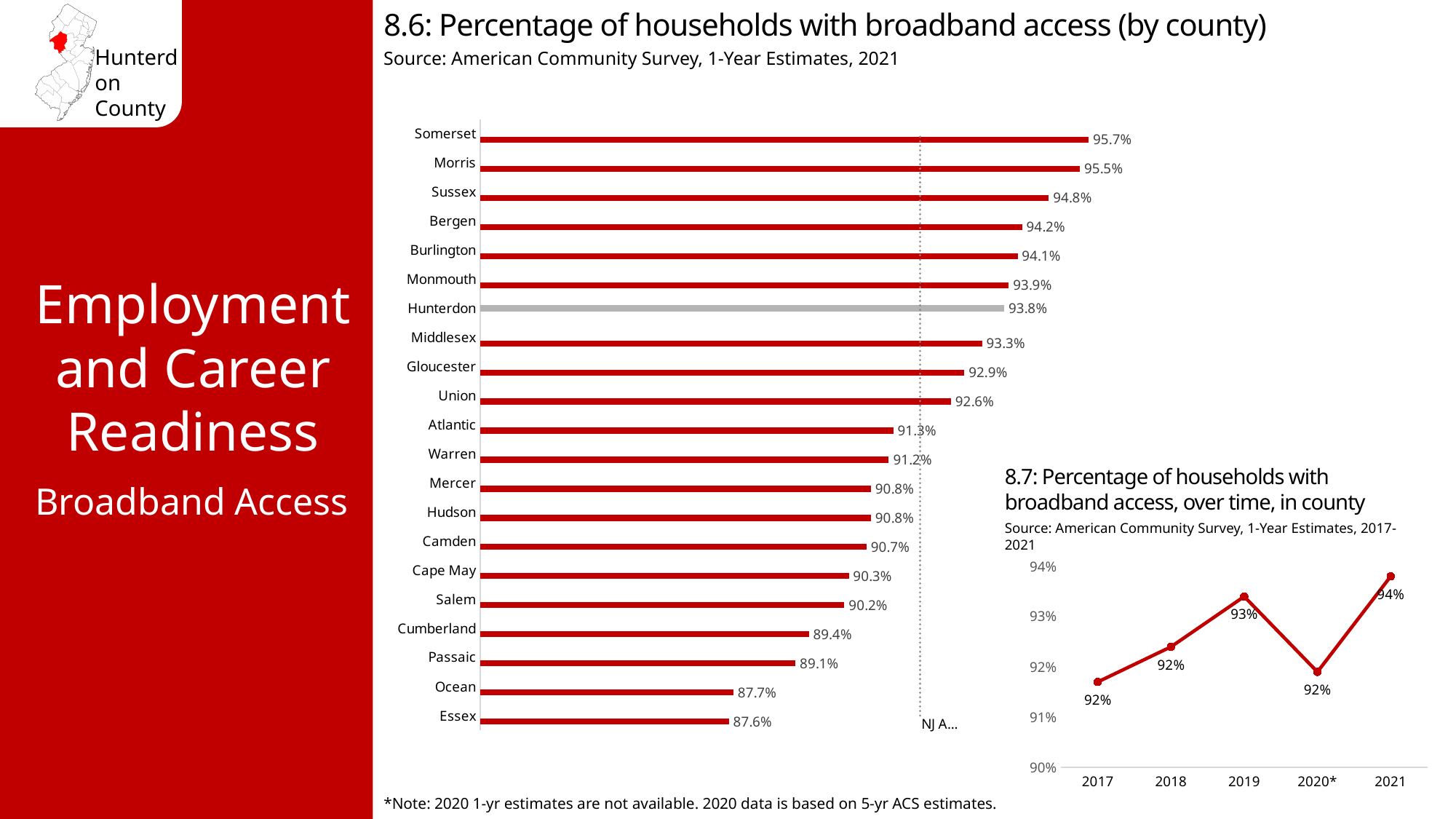
In chart 8.6, what is the percentage of households with broadband access in Hunterdon? 93.8% In chart 8.6, which county has a higher percentage, Morris or Ocean? Morris In chart 8.6, which county's bar is shown in grey instead of red? Hunterdon In chart 8.6, what is the value for Cumberland? 89.4% In chart 8.6, what is the difference between Somerset's and Essex's percentages? 8.1% What kind of chart is chart 8.6? Bar chart In chart 8.7, how many years are plotted? 5 In chart 8.6, which county has the highest percentage of households with broadband access? Somerset In chart 8.6, how many counties are shown? 21 In chart 8.6, which county has the lowest percentage of households with broadband access? Essex In chart 8.7, what is the percentage of households with broadband access in 2021? 94% In chart 8.7, do the values rise or fall from 2017 to 2019? Rise